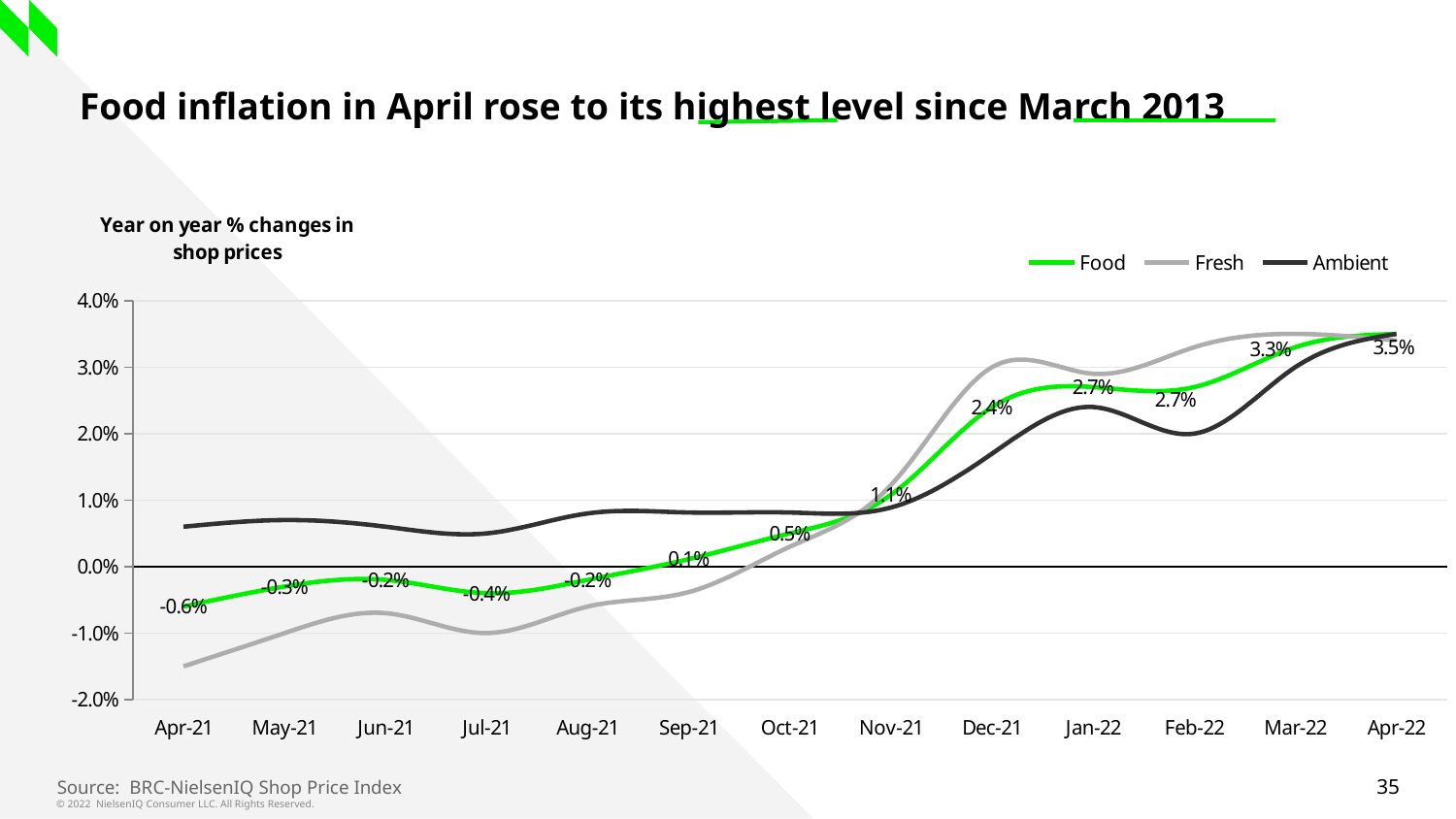
What is the Food value for Jul-21? -0.4% Is the Fresh value for Apr-21 greater or less than -1.0%? less How many months are shown on the x axis? 13 What is the Food value for Apr-22? 3.5% How many series does the legend list? 3 What is the difference between the Food value in Apr-22 and in Apr-21? 4.1 percentage points What is the Food value for Dec-21? 2.4% Does the Food series generally rise or fall from Apr-21 to Apr-22? Rise In which month is the Food series at its highest? Apr-22 Which is larger for the Food series, the value in Nov-21 or in Dec-21? Dec-21 What type of chart is shown on the slide? Line chart In which month is the Food series at its lowest? Apr-21